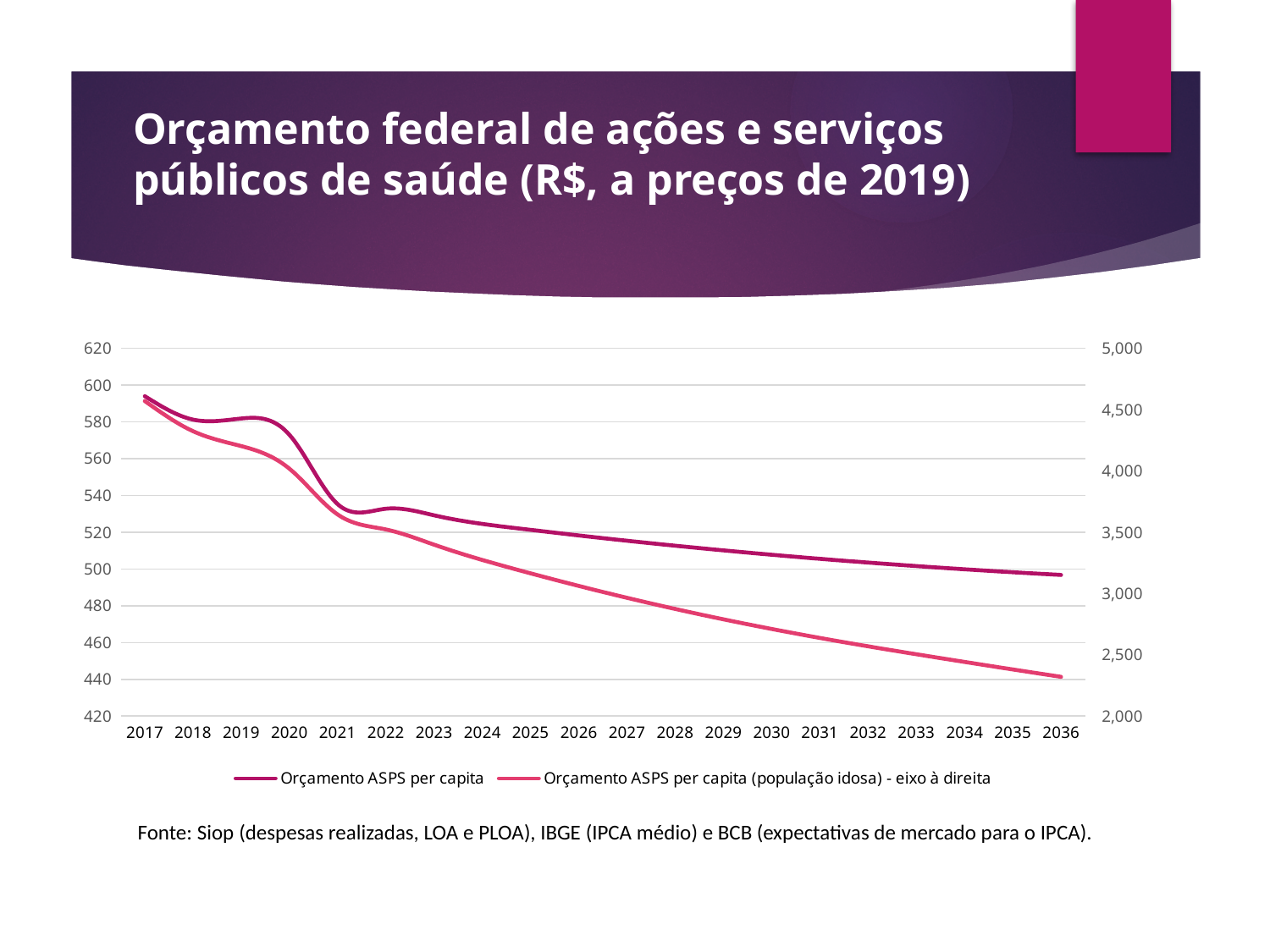
Do the values for 'Orçamento ASPS per capita (população idosa) - eixo à direita' rise or fall from 2017 to 2036? fall What kind of chart is shown on the slide? line chart Is the value for 'Orçamento ASPS per capita (população idosa) - eixo à direita' in 2017 greater or less than 4,000? greater Is the value for 'Orçamento ASPS per capita' in 2017 greater or less than 580? greater How many series does the legend list? 2 What is the last year shown on the x axis? 2036 Do the values for 'Orçamento ASPS per capita' rise or fall from 2017 to 2036? fall Is the value for 'Orçamento ASPS per capita' in 2036 greater or less than 520? less What is the first year shown on the x axis? 2017 In which year is 'Orçamento ASPS per capita' at its highest? 2017 How many years are plotted along the x axis? 20